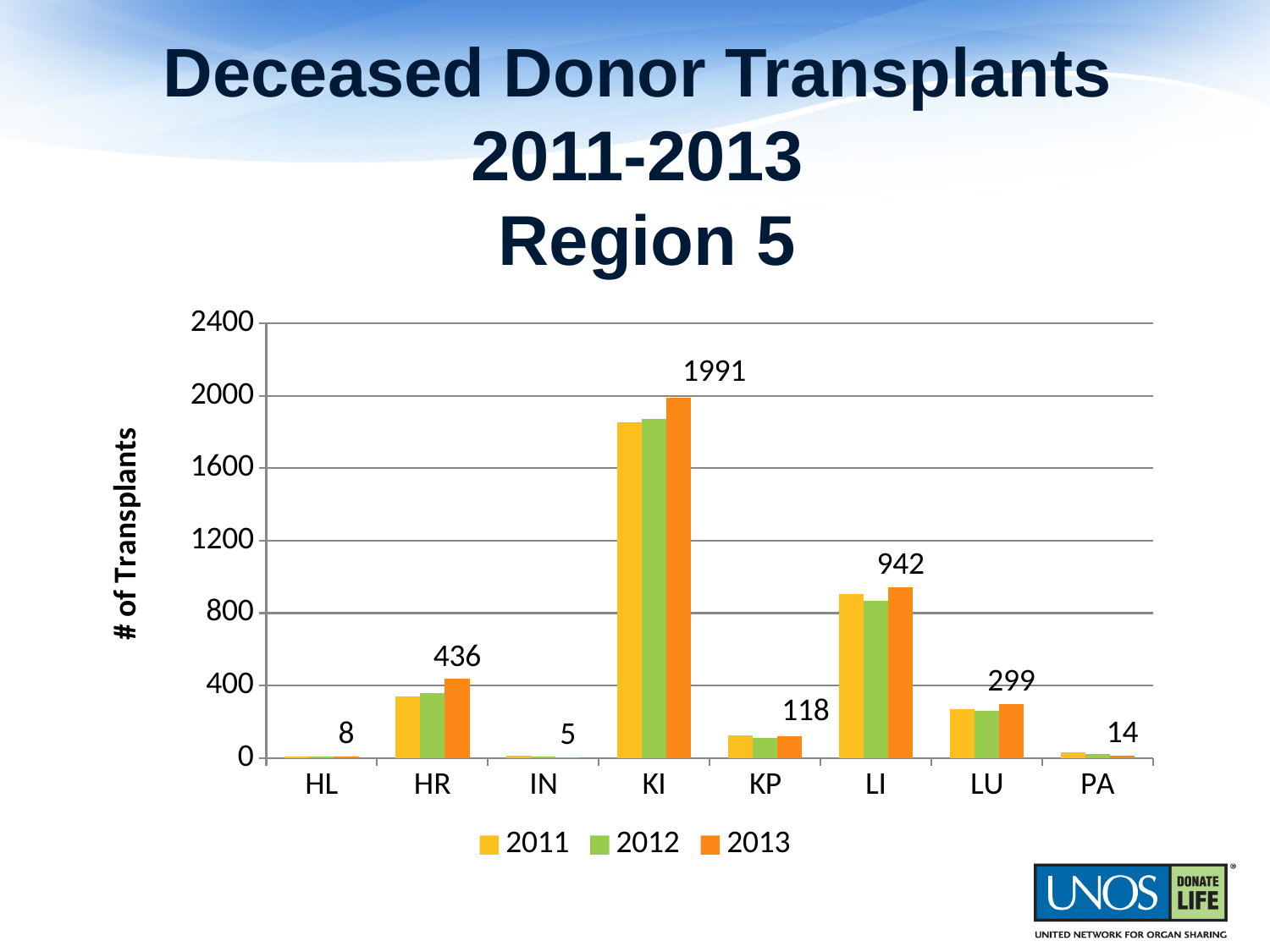
How many series does the legend list? 3 Which category has the lowest number of transplants in 2013? IN What is the value for KI in 2013? 1991 What is the value for PA in 2013? 14 How many categories are shown on the x axis? 8 What is the value for HR in 2013? 436 What kind of chart is shown on the slide? bar chart Which is larger in 2013, HR or LU? HR What is the difference between the 2013 values for KI and LI? 1049 What is the value for LI in 2013? 942 Which category has the highest number of transplants in 2013? KI Is the value for KI in 2011 greater or less than 2000? less